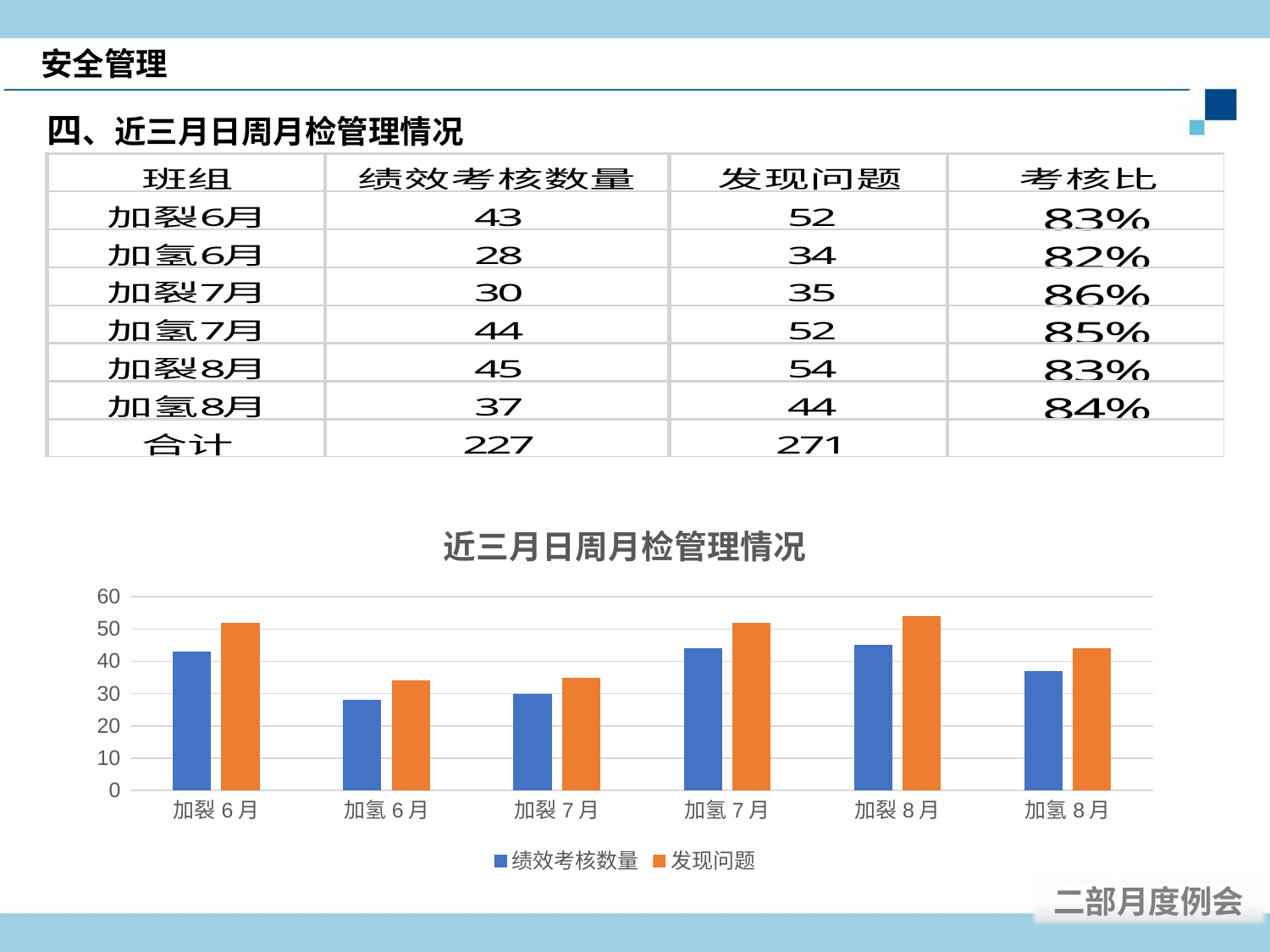
Which series is shown in orange in the chart? 发现问题 What type of chart is shown on the slide? bar chart Which is larger, the 绩效考核数量 for 加氢7月 or for 加裂8月? 加裂8月 Which category has the highest 发现问题 value? 加裂8月 How many categories are shown on the x axis of the chart? 6 What is the difference between 发现问题 and 绩效考核数量 for 加裂7月? 5 How many series does the chart legend list? 2 Is the 发现问题 value for 加氢6月 greater or less than 40? less What is the 发现问题 value for 加氢8月? 44 What is the title of the chart? 近三月日周月检管理情况 Which category has the lowest 绩效考核数量 value? 加氢6月 What is the 绩效考核数量 value for 加裂6月? 43